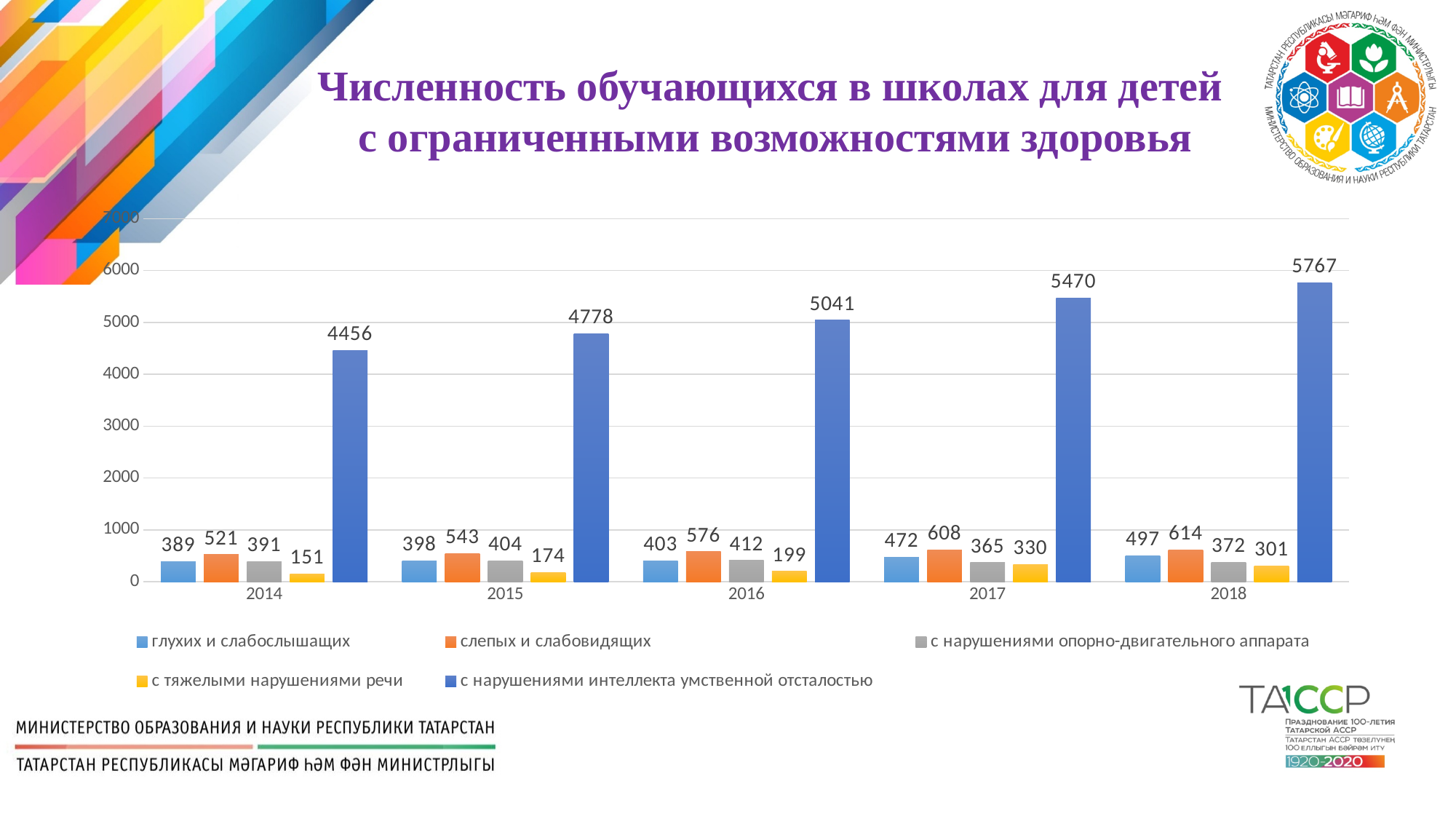
How many years are shown on the x axis? 5 What is the value for «с нарушениями интеллекта умственной отсталостью» in 2018? 5767 In which year is the value for «с тяжелыми нарушениями речи» the lowest? 2014 How many series does the legend list? 5 Which is larger in 2017: «глухих и слабослышащих» or «слепых и слабовидящих»? слепых и слабовидящих What kind of chart is shown on the slide? bar chart Does the value for «слепых и слабовидящих» rise or fall from 2014 to 2018? rise Is the value for «с нарушениями интеллекта умственной отсталостью» in 2016 greater or less than 5000? greater What is the value for «с тяжелыми нарушениями речи» in 2014? 151 What is the value for «слепых и слабовидящих» in 2016? 576 In which year is the value for «с нарушениями интеллекта умственной отсталостью» the highest? 2018 What is the difference between the 2018 and 2014 values for «с нарушениями интеллекта умственной отсталостью»? 1311